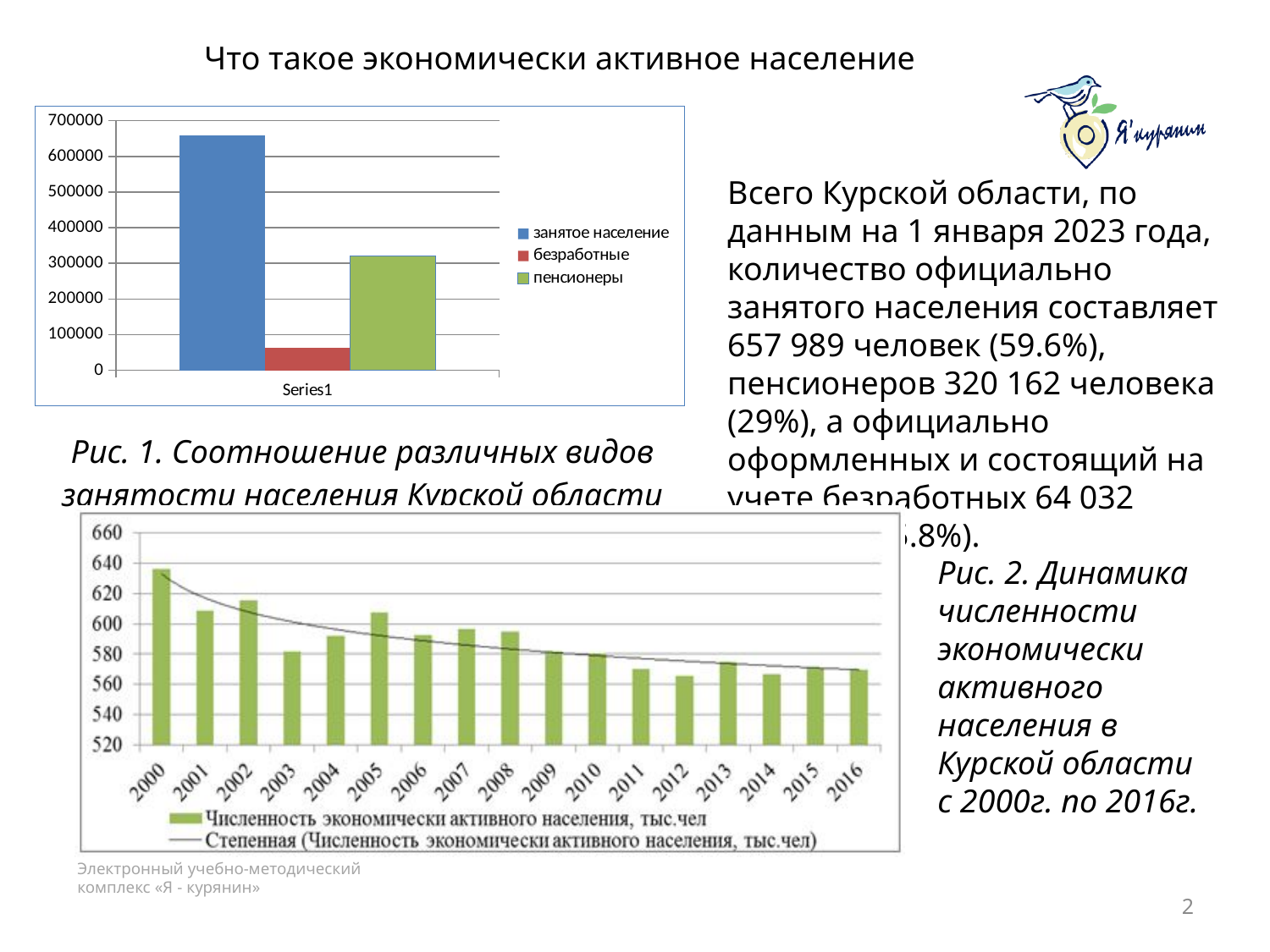
In the top chart (Рис. 1), is the value for занятое население greater or less than 600000? greater How many entries does the legend of the bottom chart (Рис. 2) list? 2 In the bottom chart (Рис. 2), which year has the highest bar? 2000 In the bottom chart (Рис. 2), do the bar values generally rise or fall from 2000 to 2016? fall In the top chart (Рис. 1), which series has the lowest value? безработные What kind of chart is the top chart (Рис. 1)? bar chart How many years are plotted as bars in the bottom chart (Рис. 2)? 17 In the bottom chart (Рис. 2), is the value for 2003 greater or less than 600? less In the top chart (Рис. 1), which series has the highest value? занятое население In the top chart (Рис. 1), is the value for пенсионеры greater or less than 400000? less In the top chart (Рис. 1), which is larger: пенсионеры or безработные? пенсионеры How many series does the legend of the top chart (Рис. 1) list? 3